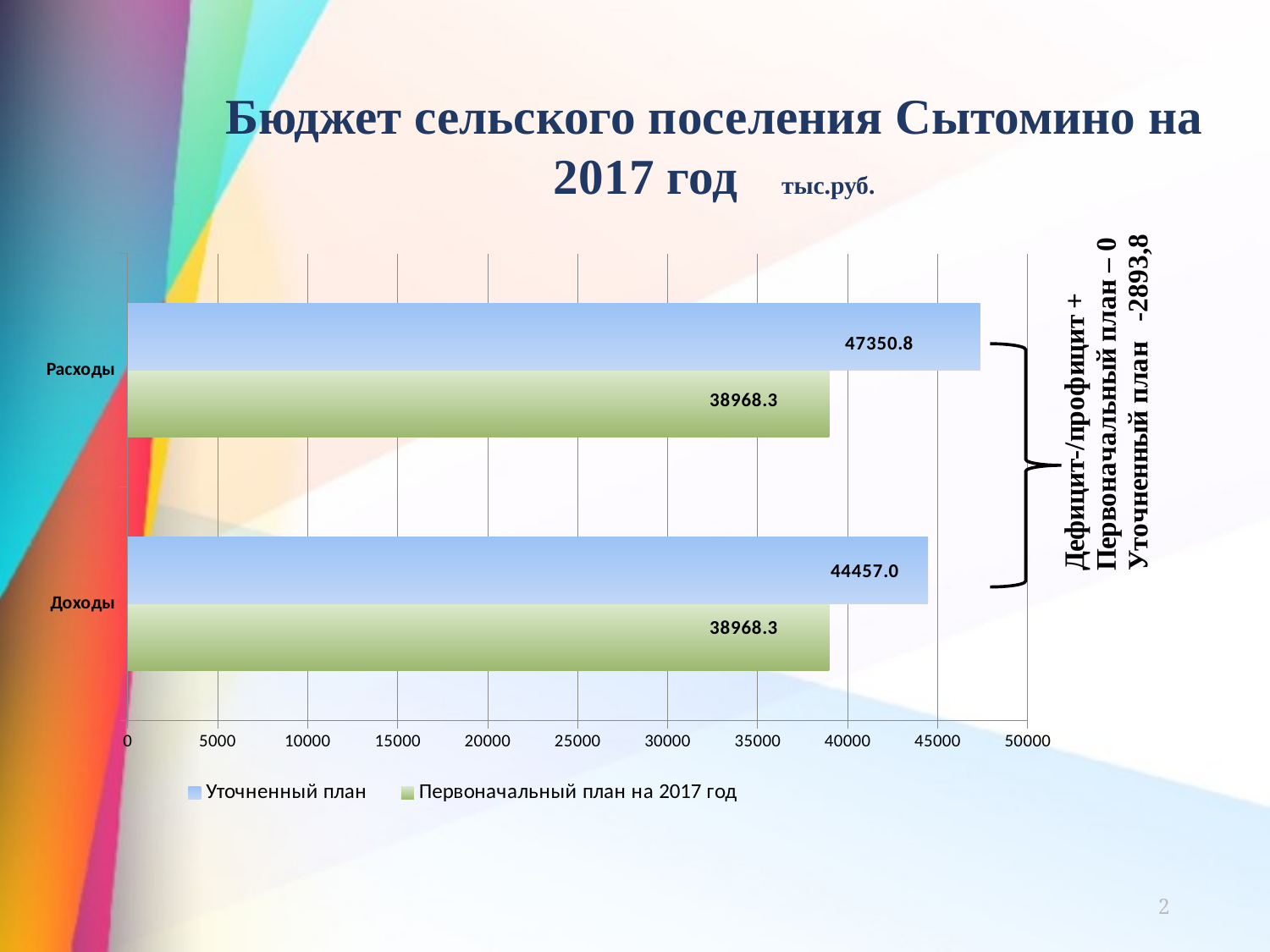
How many series does the legend list? 2 Is the value of Уточненный план for Доходы greater or less than 40000? greater How many categories are shown on the vertical axis? 2 What is the difference between Уточненный план and Первоначальный план на 2017 год for Расходы? 8382.5 What is the value of Уточненный план for Доходы? 44457.0 Which category has the higher value for Уточненный план, Расходы or Доходы? Расходы What is the difference between Уточненный план and Первоначальный план на 2017 год for Доходы? 5488.7 What is the value of Первоначальный план на 2017 год for Расходы? 38968.3 What is the value of Уточненный план for Расходы? 47350.8 Which series is shown in green in the legend? Первоначальный план на 2017 год What type of chart is shown on the slide? bar chart What is the value of Первоначальный план на 2017 год for Доходы? 38968.3